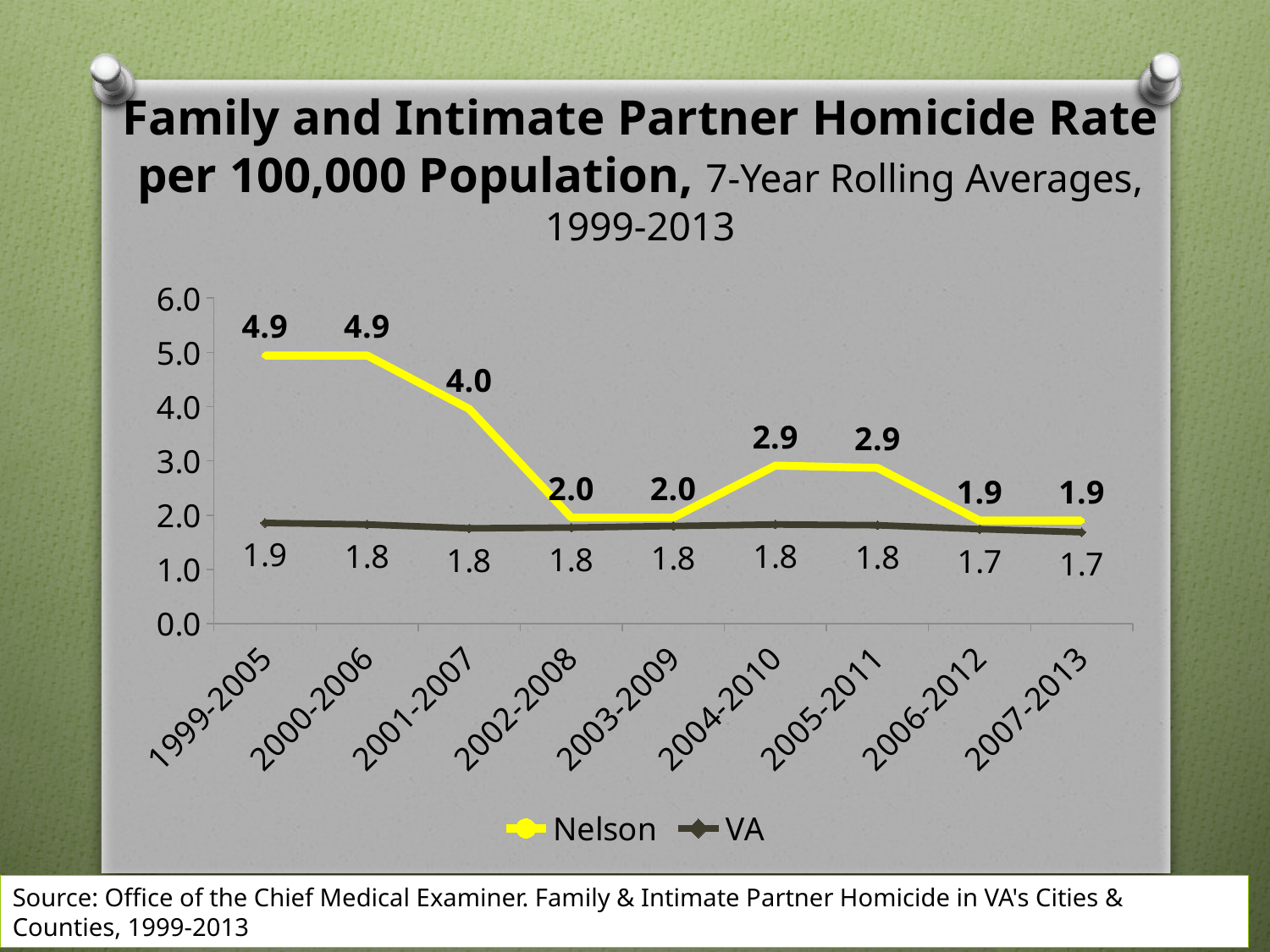
What is the difference between the Nelson values for 2000-2006 and 2001-2007? 0.9 What is the difference between the Nelson and VA values for 1999-2005? 3.0 Which is larger for 2002-2008, the Nelson value or the VA value? Nelson Does the Nelson series generally rise or fall from 1999-2005 to 2007-2013? Fall Which period has the highest VA value? 1999-2005 How many periods are shown on the x axis? 9 What kind of chart is this? Line chart What is the VA value for 2007-2013? 1.7 What is the Nelson value for 2004-2010? 2.9 How many series does the legend list? 2 What is the Nelson value for 2001-2007? 4.0 Which period has the lowest Nelson value? 2006-2012 and 2007-2013 (1.9)